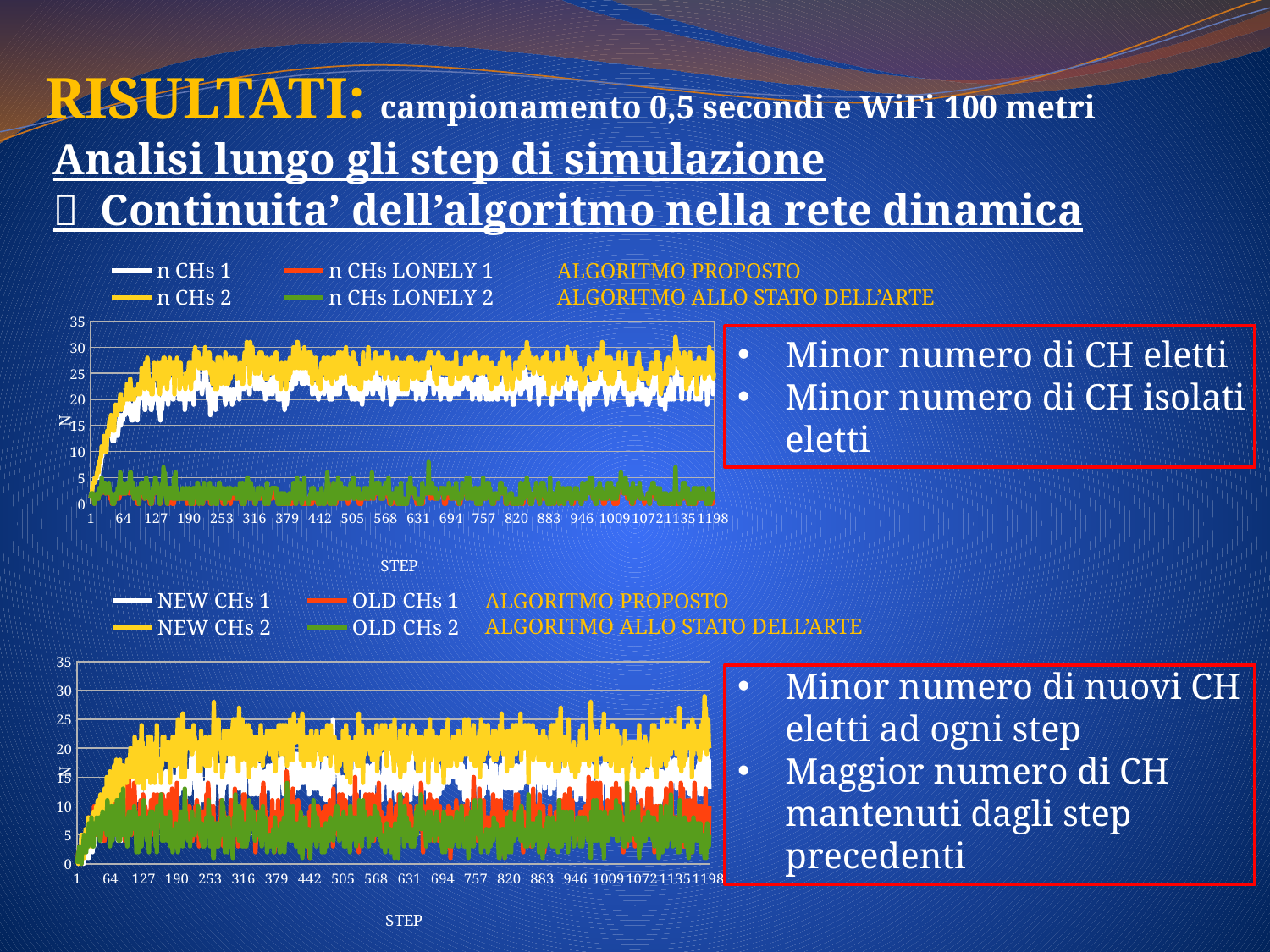
In the bottom chart, are the values of OLD CHs 2 greater or less than 20 across the simulation steps? less What kind of chart is the top chart on the slide? line chart In the top chart, which series generally has higher values after the initial rise: n CHs 1 or n CHs 2? n CHs 2 In the top chart, are the values of n CHs LONELY 2 greater or less than 10 across the simulation steps? less In the bottom chart, which series generally has higher values after the initial rise: NEW CHs 1 or NEW CHs 2? NEW CHs 2 What kind of chart is the bottom chart on the slide? line chart How many series does the legend of the bottom chart list? 4 In the top chart, after the initial rise, are the values of n CHs 2 greater or less than 15? greater In the bottom chart, which series is drawn in yellow? NEW CHs 2 In the top chart, what is the label of the x axis? STEP How many series does the legend of the top chart list? 4 In the top chart, which series generally has higher values: n CHs 1 or n CHs LONELY 1? n CHs 1